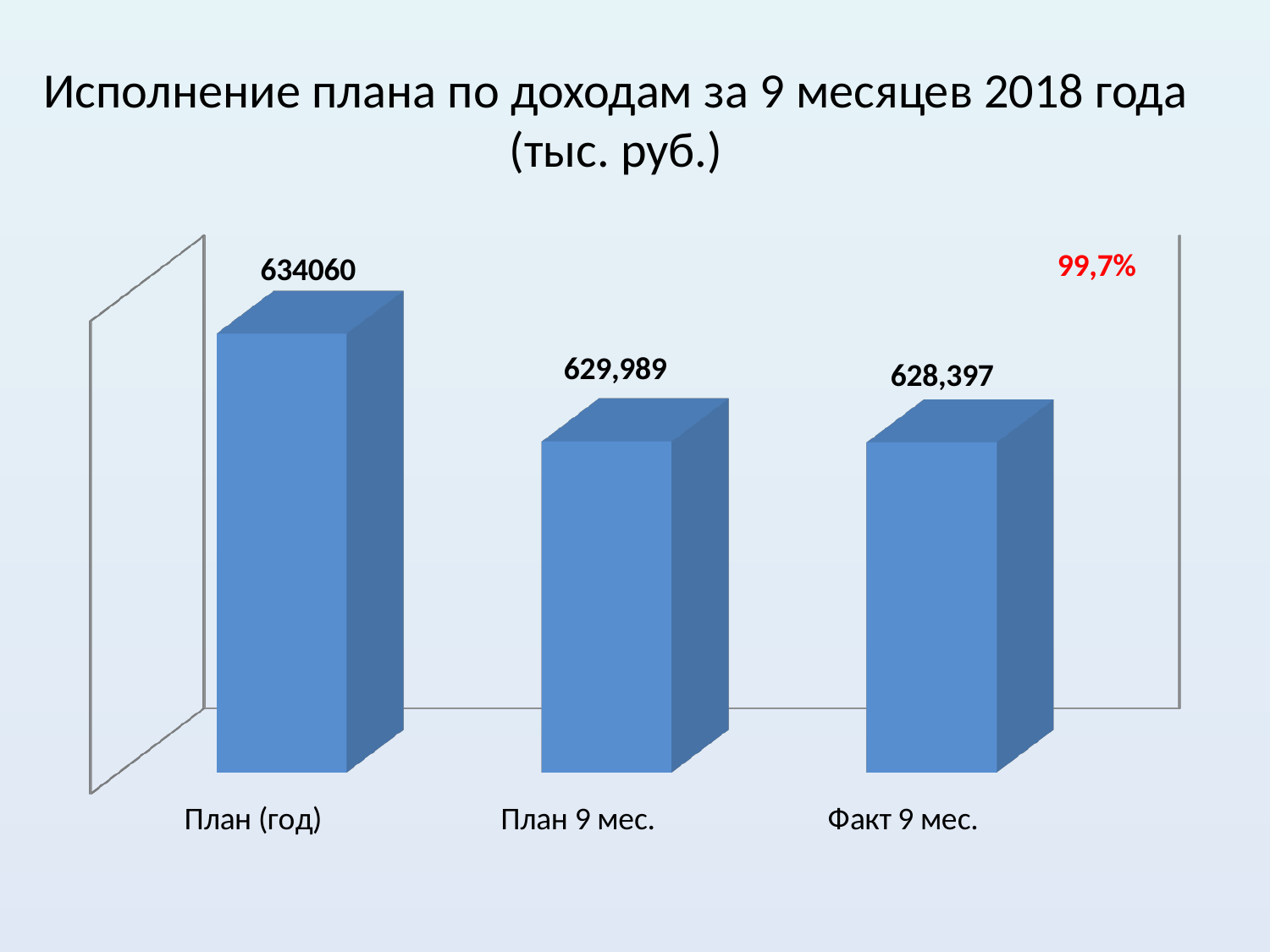
How many categories are shown in the chart? 3 Which is larger, the value for План 9 мес. or the value for Факт 9 мес.? План 9 мес. What is the value for Факт 9 мес.? 628,397 Which category has the highest value? План (год) Do the values rise or fall from left to right across the categories? Fall What kind of chart is shown on the slide? Bar chart What is the difference between the values for План 9 мес. and Факт 9 мес.? 1,592 What percentage is shown in red in the upper right of the chart? 99,7% What is the difference between the values for План (год) and План 9 мес.? 4,071 What is the value for План 9 мес.? 629,989 What is the value for План (год)? 634060 Which category has the lowest value? Факт 9 мес.